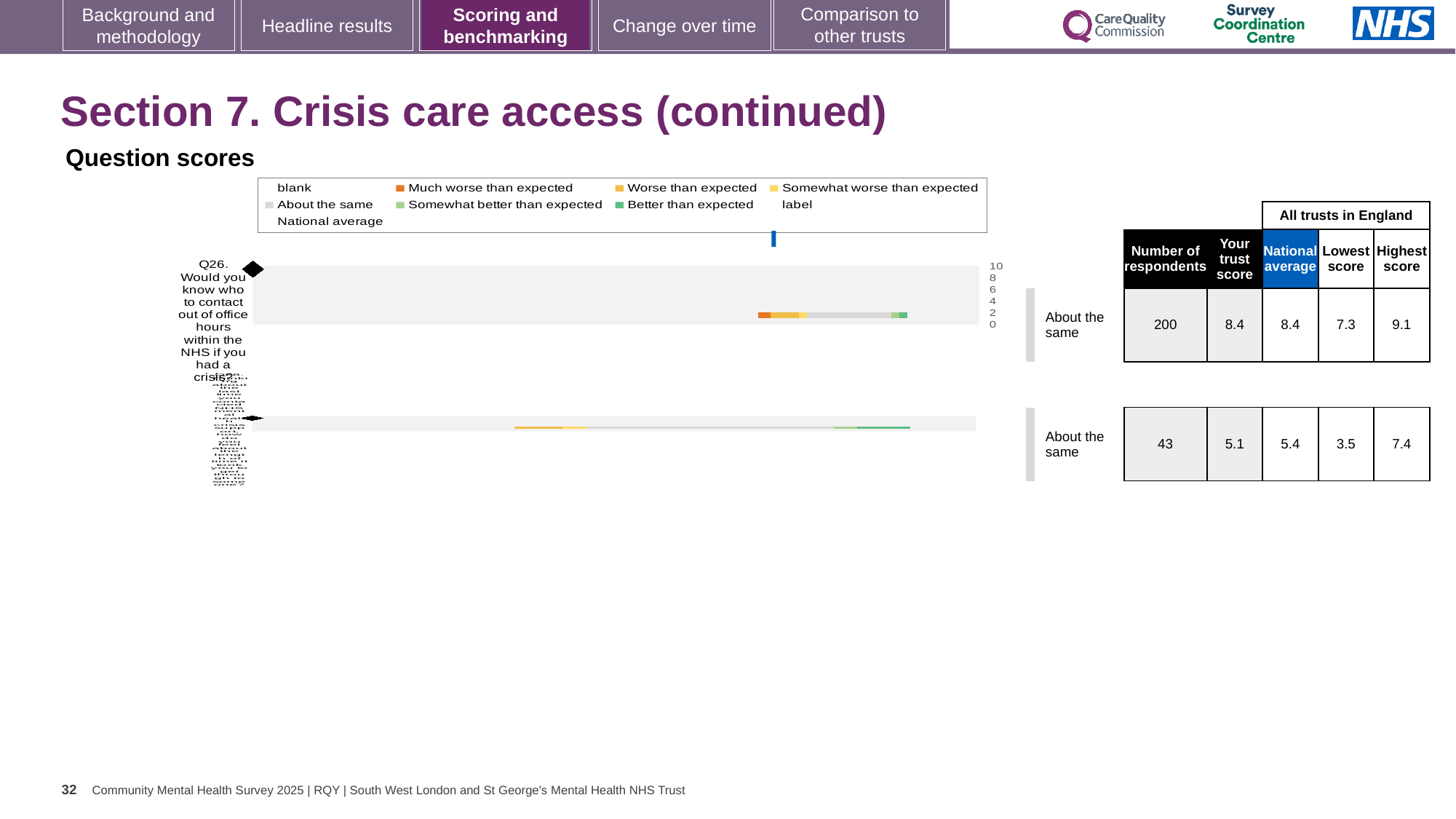
What is the highest score among all trusts in England for Q26? 9.1 How many question bars are plotted in the question scores chart? 2 What is the number of respondents for Q26 (Would you know who to contact out of office hours within the NHS if you had a crisis?)? 200 What is the lowest score among all trusts in England for Q26? 7.3 What benchmark category is shown for Q26? About the same In the chart legend, what colour represents 'Much worse than expected'? orange Is the trust score for Q26 higher than, lower than, or the same as the national average? the same What is the difference between the highest and lowest trust scores for Q26? 1.8 What is the national average score for Q26? 8.4 In the chart legend, what colour represents 'About the same'? grey What kind of chart is used to show the question scores on this slide? bar chart What is the trust score for Q26? 8.4